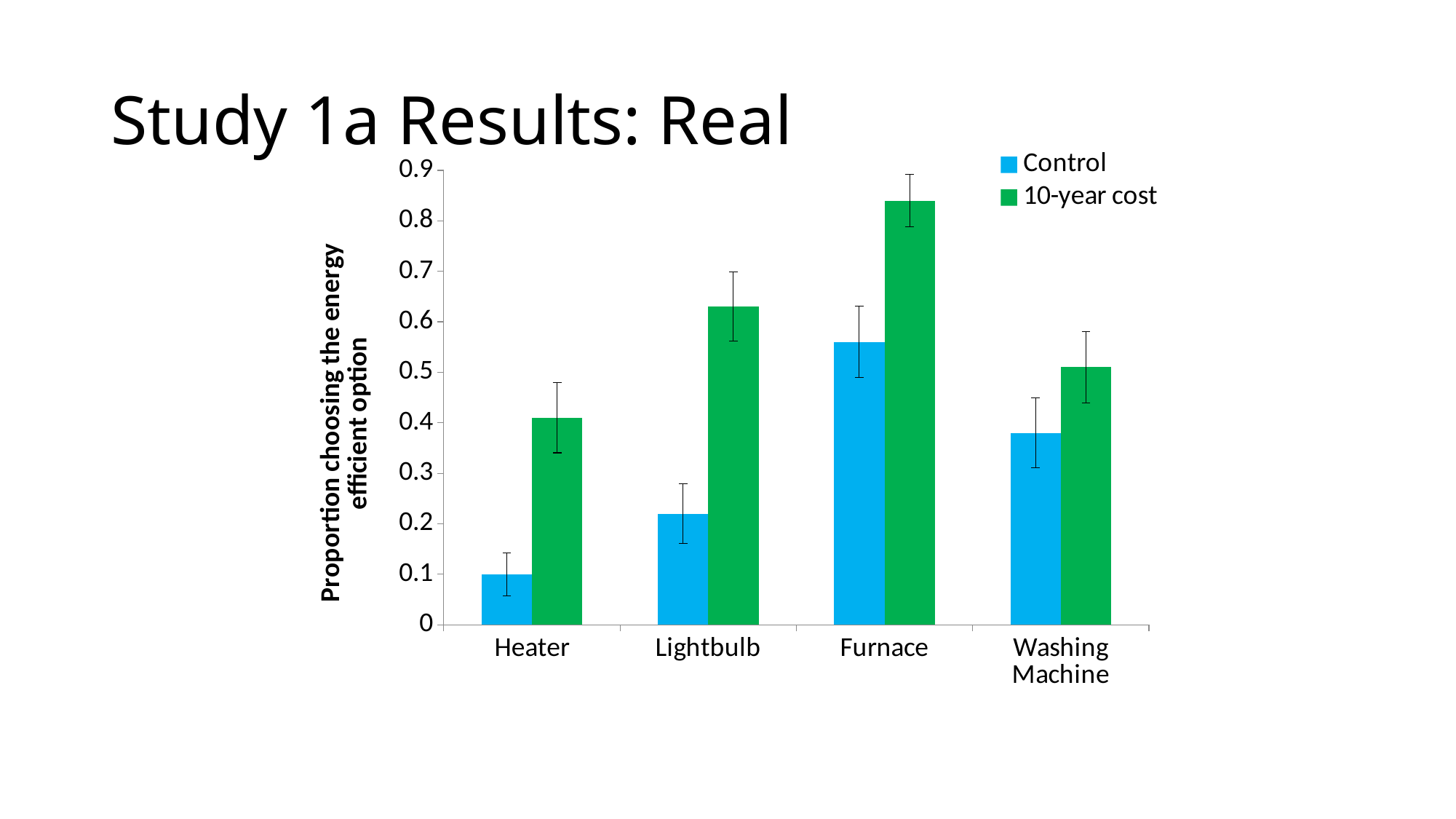
Which is larger: the Control value for Lightbulb or the Control value for Washing Machine? Washing Machine How many series does the legend list? 2 What colour represents the Control series? blue Is the Control value for Lightbulb greater or less than 0.3? less Which category has the lowest Control bar? Heater Is the 10-year cost value for Furnace greater or less than 0.8? greater In every category, which series has the higher bar? 10-year cost What is the title of the y axis? Proportion choosing the energy efficient option Is the 10-year cost value for Heater greater or less than 0.5? less What kind of chart is shown on the slide? bar chart Which category has the highest 10-year cost bar? Furnace How many product categories are shown on the x axis? 4